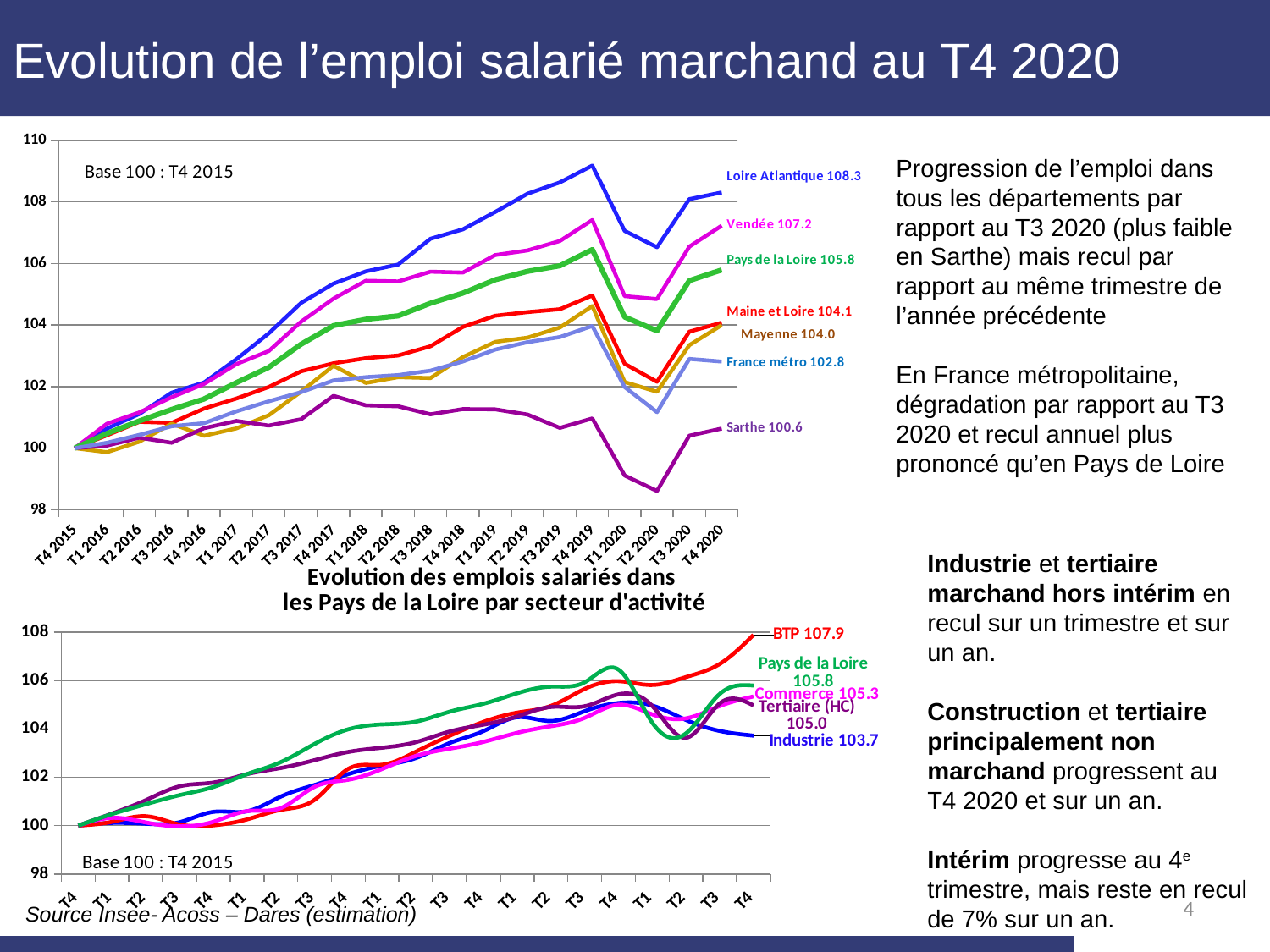
In the top chart, what is the T4 2020 value for Loire Atlantique? 108.3 In the top chart, what is the T4 2020 value for Sarthe? 100.6 In the bottom chart, what is the final value for BTP? 107.9 In the top chart, is the value for Sarthe at T2 2020 greater or less than 100? less In the bottom chart, which sector has the lowest final value? Industrie In the top chart, which is larger at T4 2020: Vendée or France métro? Vendée In the bottom chart, what is the difference between the final values of BTP and Industrie? 4.2 In the top chart, how many series are plotted? 7 In the top chart, what is the difference between the T4 2020 values of Loire Atlantique and Sarthe? 7.7 In the top chart, which series has the highest value at T4 2020? Loire Atlantique In the top chart, which series has the lowest value at T4 2020? Sarthe What type of chart is the bottom chart? Line chart